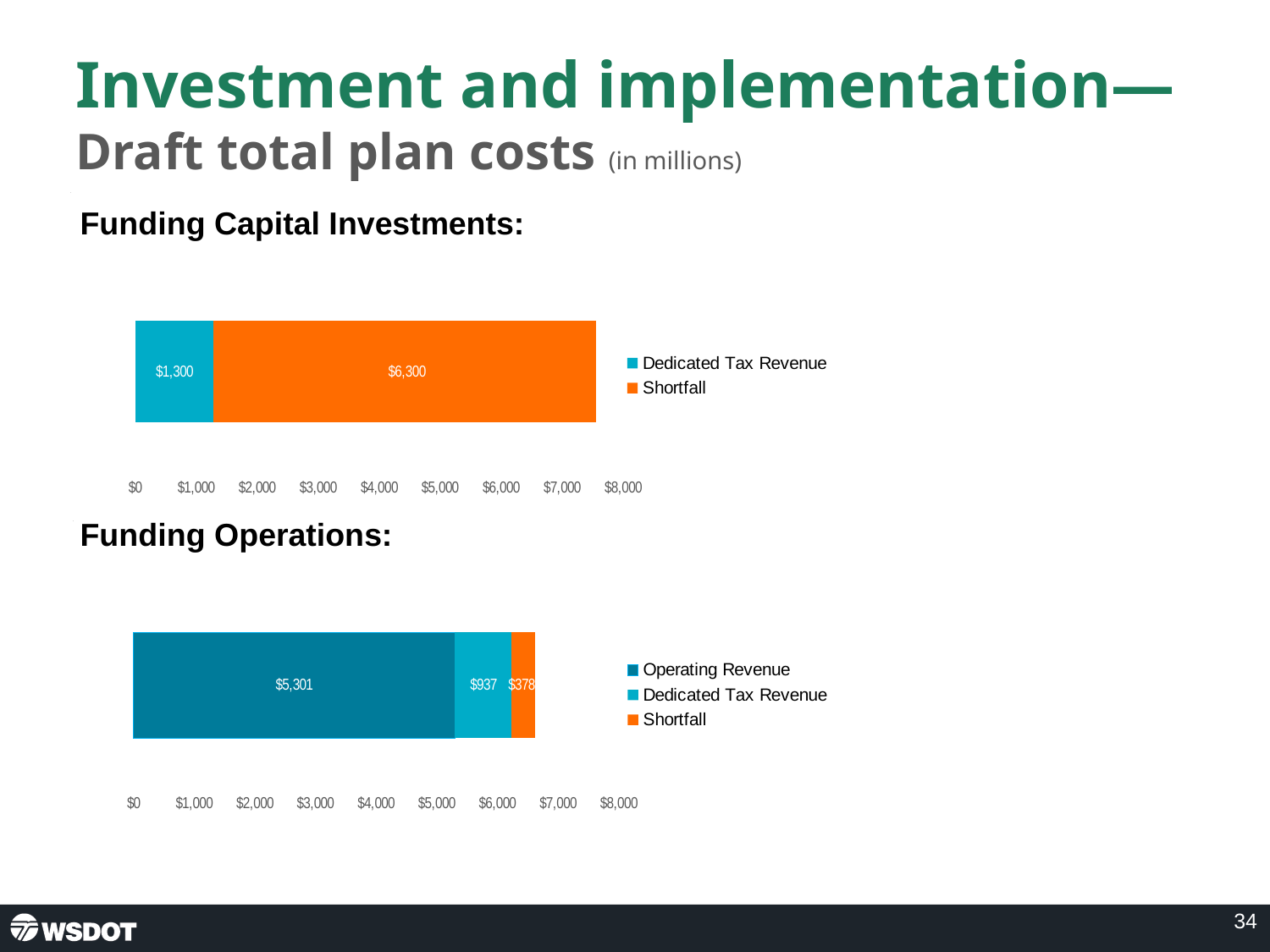
In the Funding Capital Investments chart, what is the value for Shortfall? $6,300 What kind of chart is the Funding Operations chart? Stacked bar chart In the Funding Capital Investments chart, what is the difference between Shortfall and Dedicated Tax Revenue? $5,000 In the Funding Capital Investments chart, what is the total of the stacked bar? $7,600 In the Funding Capital Investments chart, what is the value for Dedicated Tax Revenue? $1,300 In the Funding Operations chart, which series has the smallest value? Shortfall In the Funding Operations chart, what is the total of the stacked bar? $6,616 In the Funding Operations chart, what is the value for Shortfall? $378 In the Funding Operations chart, what is the value for Dedicated Tax Revenue? $937 In the Funding Operations chart, which series has the largest value? Operating Revenue In the Funding Operations chart, what is the value for Operating Revenue? $5,301 In the Funding Capital Investments chart, how many series does the legend list? 2